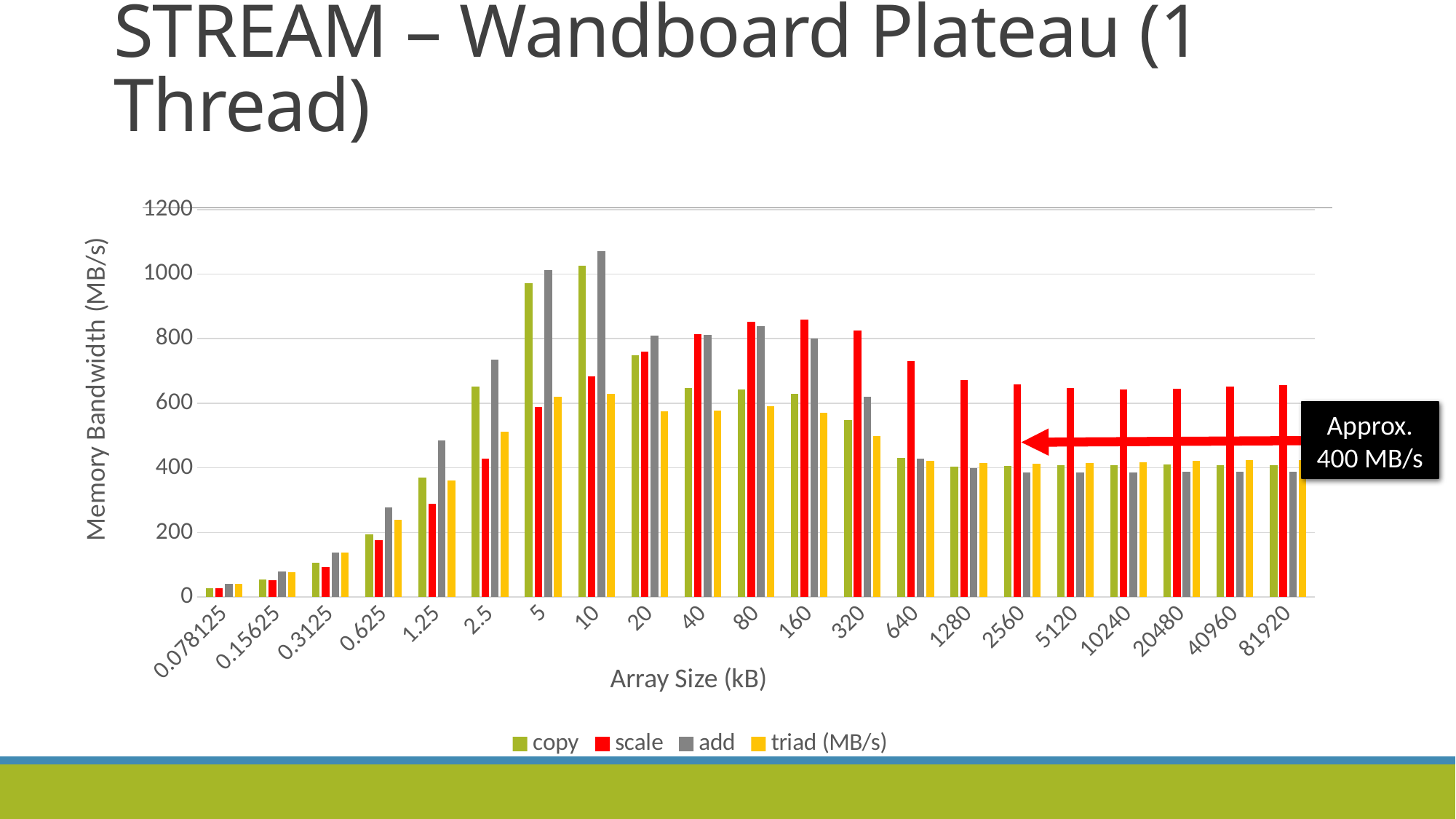
Is the add value at array size 10 greater or less than 1000? greater Is the scale value at array size 160 greater or less than 800? greater At array size 320, which is larger, the scale value or the copy value? scale What kind of chart is shown on the slide? bar chart Does the copy series rise or fall from array size 0.078125 to array size 10? rise Which array size has the highest value for the copy series? 10 How many array sizes are shown along the x axis? 21 What approximate bandwidth does the annotation on the right of the chart indicate? Approx. 400 MB/s How many series does the legend list? 4 Which array size has the highest value for the add series? 10